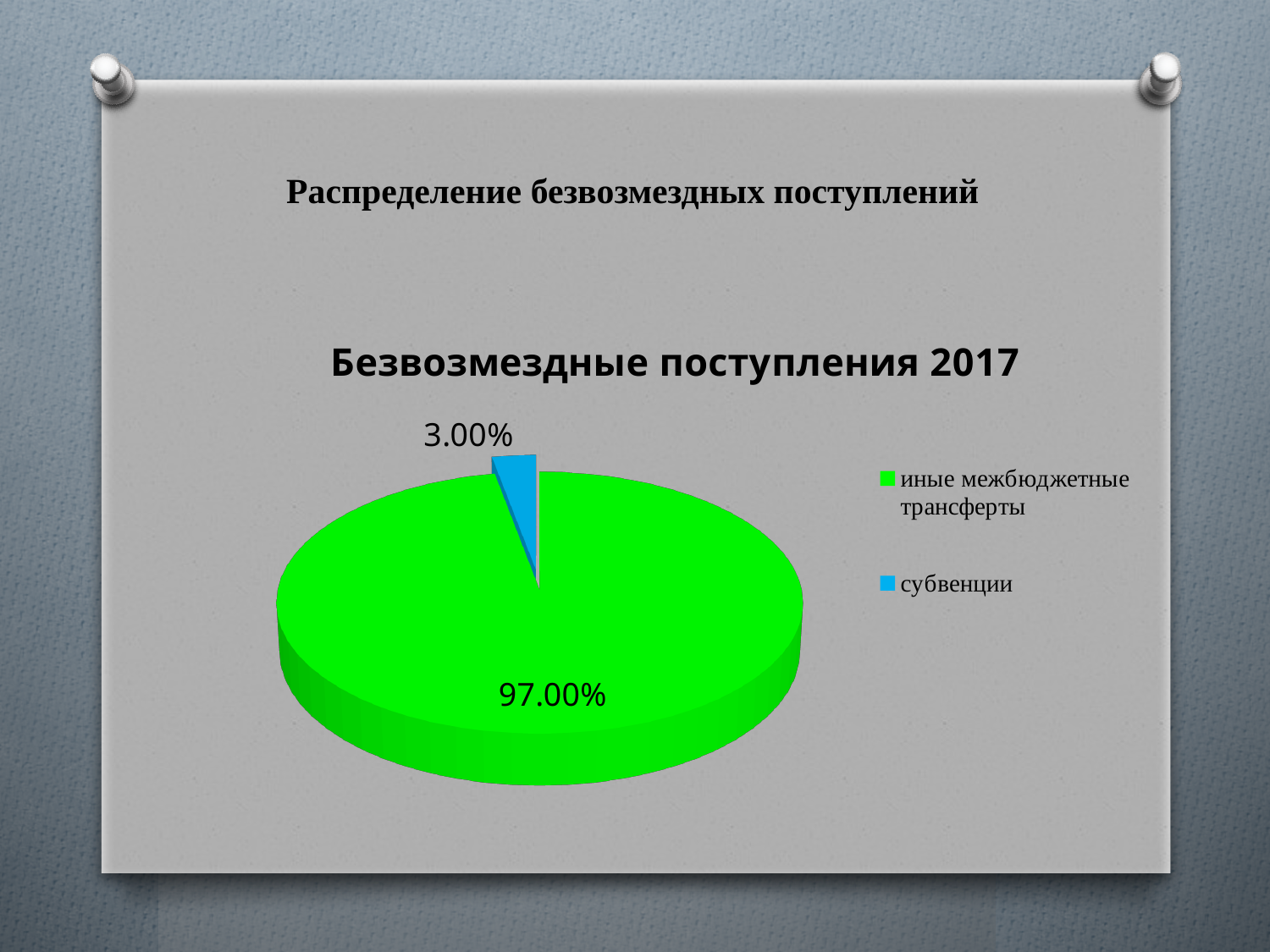
What share of the pie does "субвенции" take? 3.00% What kind of chart is shown on the slide? pie chart What is the difference in percentage points between "иные межбюджетные трансферты" and "субвенции"? 94.00% How many entries does the legend list? 2 What is the title of the chart? Безвозмездные поступления 2017 What share of the pie does "иные межбюджетные трансферты" take? 97.00% What colour is the slice for "субвенции"? blue How many categories does the pie chart show? 2 Which is larger, the share for "субвенции" or the share for "иные межбюджетные трансферты"? иные межбюджетные трансферты Which category has the largest slice of the pie? иные межбюджетные трансферты Which category has the smallest slice of the pie? субвенции